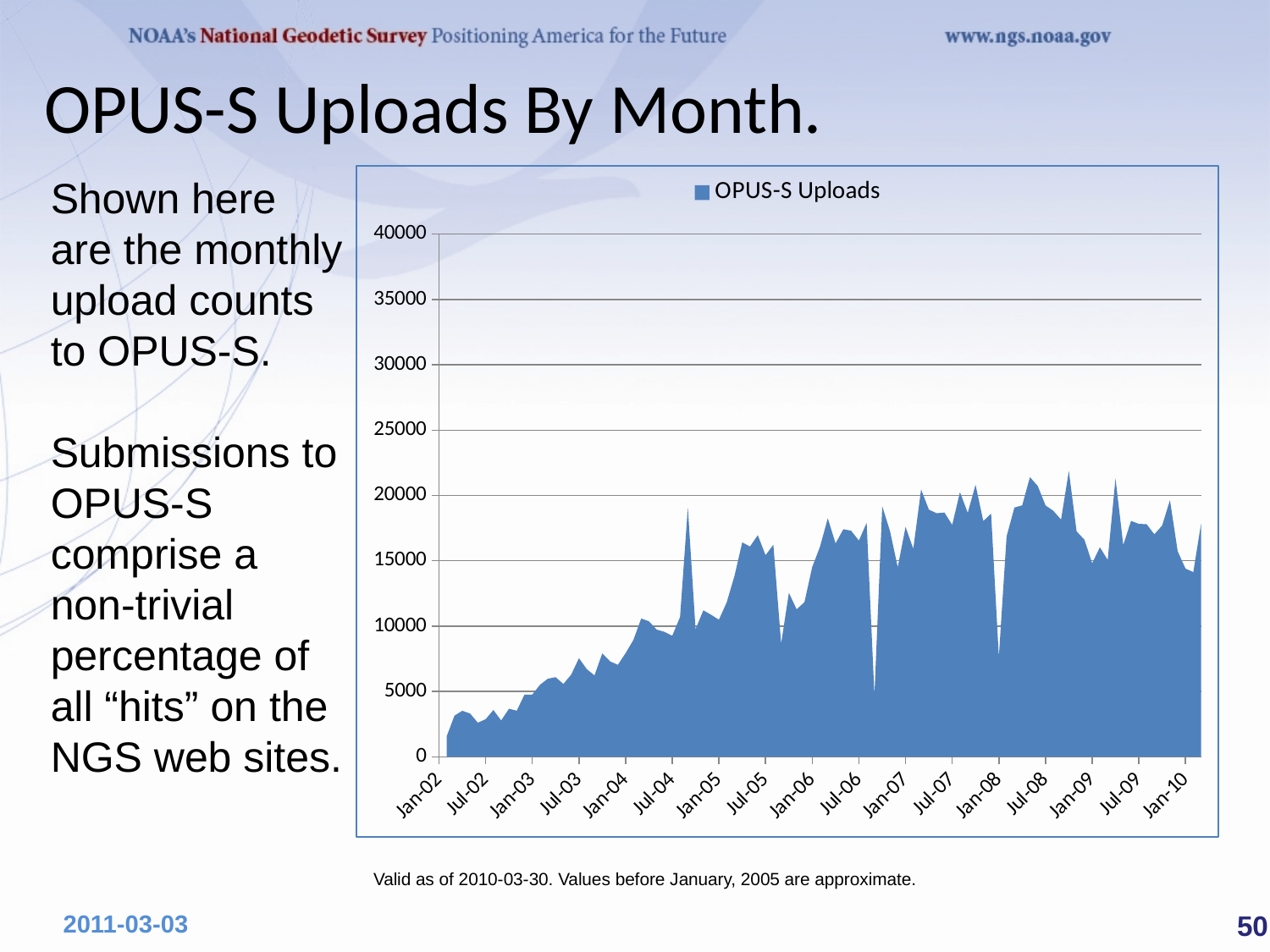
Overall, do the OPUS-S upload counts rise or fall from Jan-02 to Jan-10? rise How many series does the chart legend list? 1 Is the value for Jan-07 greater or less than 15000? greater Is the value for Jan-04 greater or less than 5000? greater Which has the larger value, Jan-08 or Jan-09? Jan-09 Is the value for Jan-02 greater or less than 5000? less What is the name of the series shown in the chart legend? OPUS-S Uploads What is the highest value shown on the vertical axis of the chart? 40000 How many month labels are shown along the horizontal axis of the chart? 17 What kind of chart is shown on the slide? area chart Which has the larger value, Jan-02 or Jan-07? Jan-07